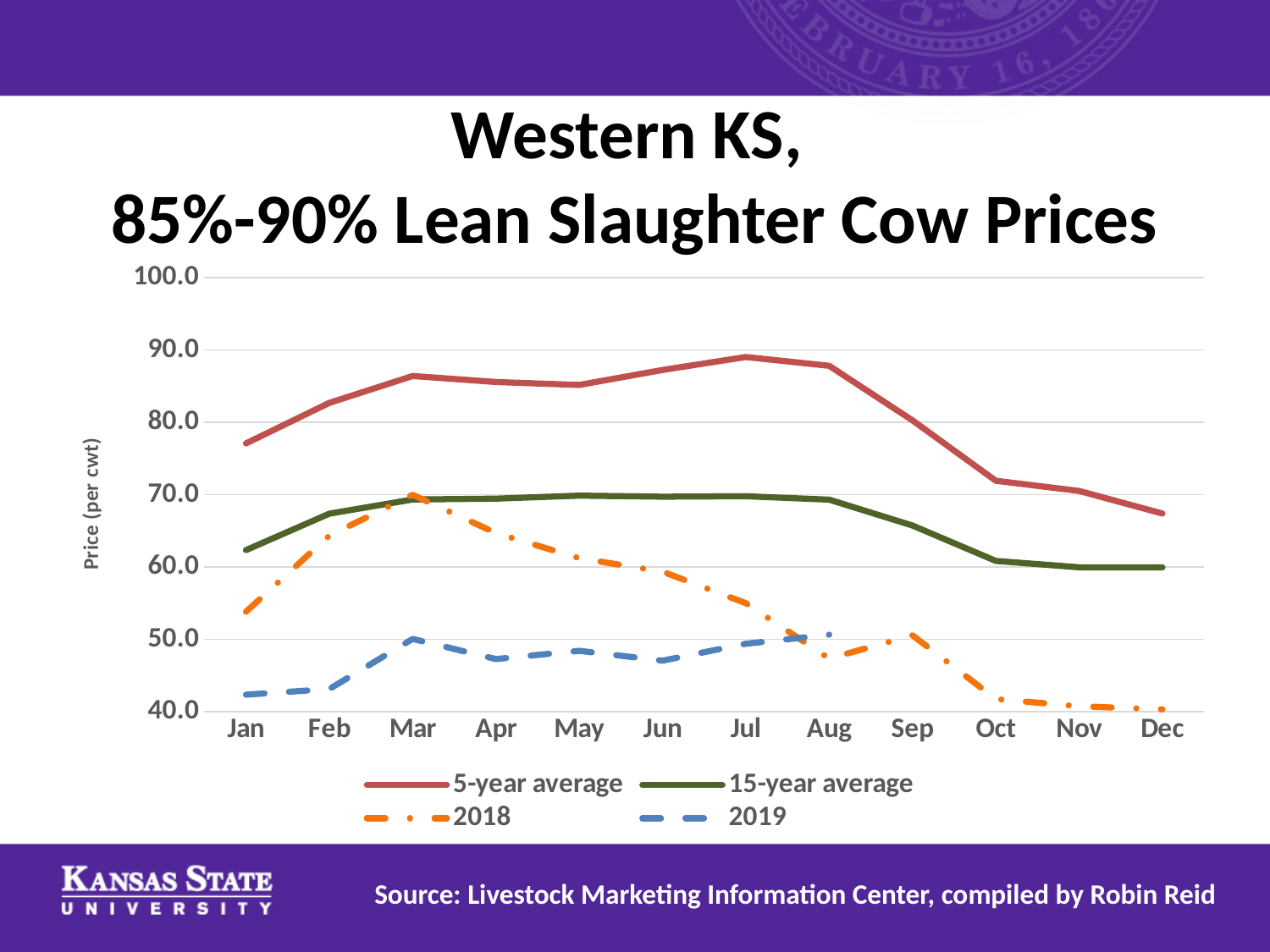
Is the 15-year average value for Dec greater or less than 70.0? less Is the 2019 value for Jan greater or less than 50.0? less Is the 2018 value for Dec greater or less than 50.0? less Does the 5-year average rise or fall from Aug to Dec? fall How many series does the legend list? 4 What is the label on the y axis? Price (per cwt) In which month does the 2018 series reach its highest value? Mar In Jan, which series is higher: 2018 or 2019? 2018 What kind of chart is shown on the slide? line chart How many months are shown along the x axis? 12 In which month does the 2018 series reach its lowest value? Dec